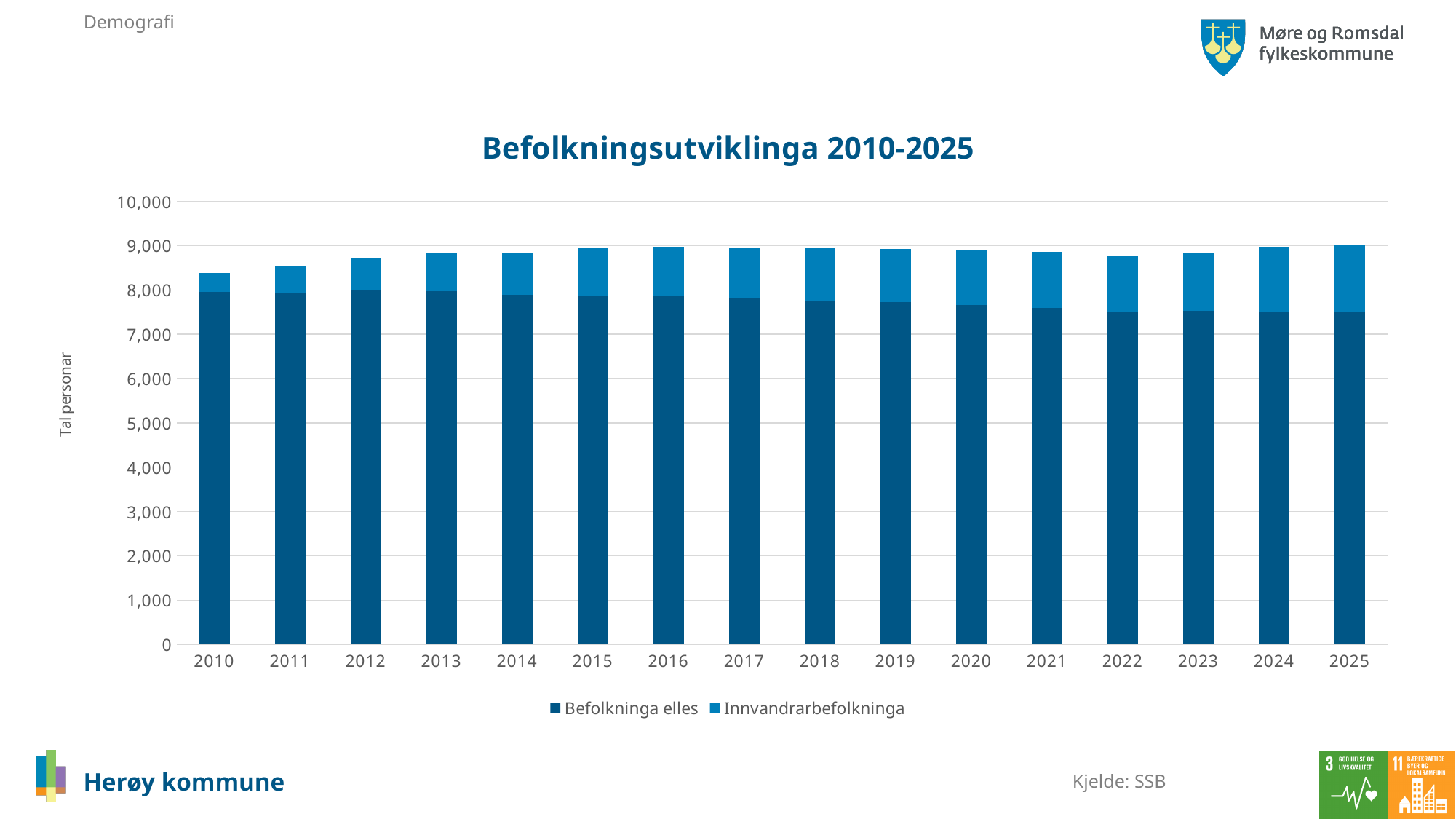
Which year has the largest Innvandrarbefolkninga segment? 2025 Is the total bar for 2025 greater or less than 8,000? greater Does the Innvandrarbefolkninga series rise or fall from 2010 to 2025? Rises What kind of chart is shown on the slide? Stacked bar chart Is the total bar for 2010 greater or less than 9,000? less Does the Befolkninga elles series rise or fall from 2010 to 2025? Falls Which year has the smallest Innvandrarbefolkninga segment? 2010 Is the Befolkninga elles value for 2025 greater or less than 8,000? less What is the label on the y axis? Tal personar How many series does the legend list? 2 Which year has the lowest total population bar? 2010 How many years are shown on the x axis? 16